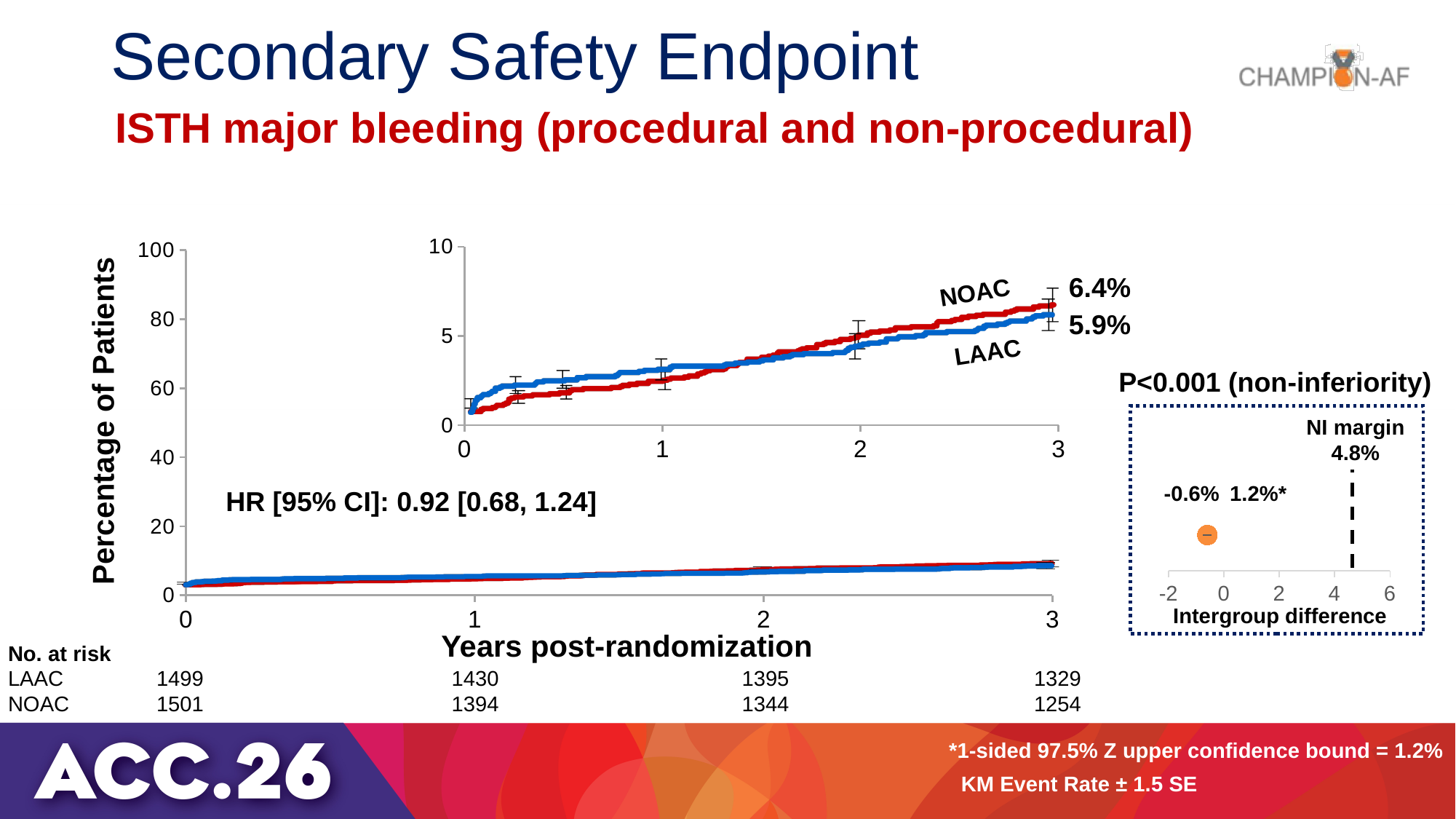
In the main Kaplan-Meier chart, what is the difference between the NOAC and LAAC 3-year event rates? 0.5% What kind of chart is the main Kaplan-Meier plot? Line chart In the main Kaplan-Meier chart, which group has the higher event rate at 3 years, NOAC or LAAC? NOAC In the main Kaplan-Meier chart, what is the 95% confidence interval for the hazard ratio? [0.68, 1.24] In the intergroup difference plot on the right, what is the non-inferiority (NI) margin? 4.8% In the main Kaplan-Meier chart, what is the 3-year ISTH major bleeding event rate for the LAAC group? 5.9% In the No. at risk table below the main chart, how many NOAC patients were at risk at year 0? 1501 In the No. at risk table below the main chart, how many LAAC patients were at risk at year 3? 1329 In the intergroup difference plot on the right, what is the point estimate of the intergroup difference? -0.6% In the main Kaplan-Meier chart, what hazard ratio is reported? 0.92 In the main Kaplan-Meier chart, what is the 3-year ISTH major bleeding event rate for the NOAC group? 6.4% In the main Kaplan-Meier chart, do the event rate curves rise or fall over the years post-randomization? Rise